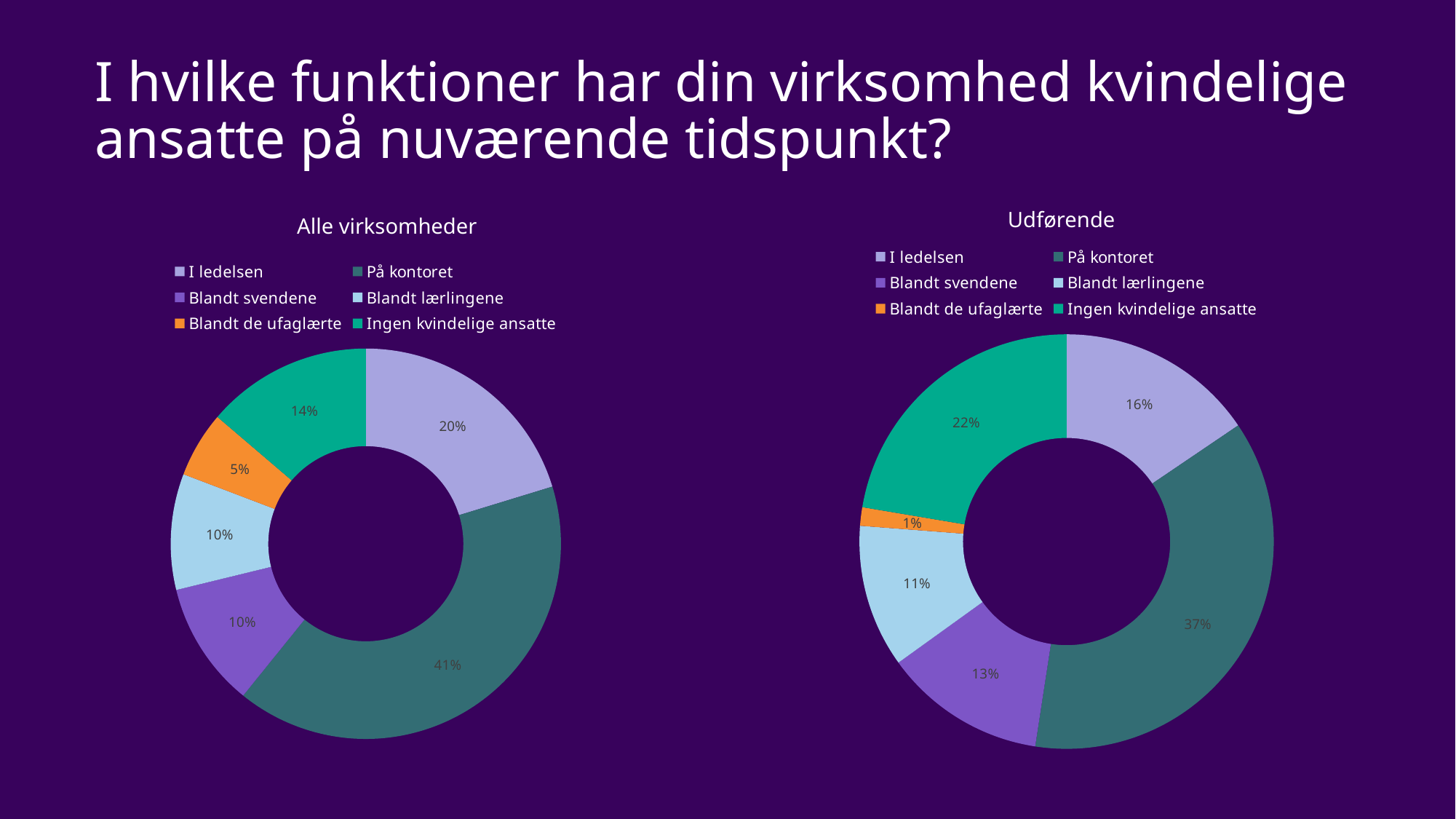
In the 'Alle virksomheder' chart, what share is shown for 'Blandt de ufaglærte'? 5% In the 'Udførende' chart, what share is shown for 'Ingen kvindelige ansatte'? 22% In the 'Alle virksomheder' chart, which is larger: 'I ledelsen' or 'Ingen kvindelige ansatte'? I ledelsen In the 'Alle virksomheder' chart, what share is shown for 'På kontoret'? 41% What kind of chart is the 'Alle virksomheder' chart? Doughnut chart What is the title of the chart on the right side of the slide? Udførende In the 'Udførende' chart, what share is shown for 'Blandt de ufaglærte'? 1% How many categories does the legend of the 'Udførende' chart list? 6 In the 'Alle virksomheder' chart, which category has the largest share? På kontoret In the 'Udførende' chart, what is the difference in percentage points between 'På kontoret' and 'I ledelsen'? 21 In the 'Alle virksomheder' chart, what is the combined share of 'Blandt svendene' and 'Blandt lærlingene'? 20% In the 'Udførende' chart, which category has the smallest share? Blandt de ufaglærte